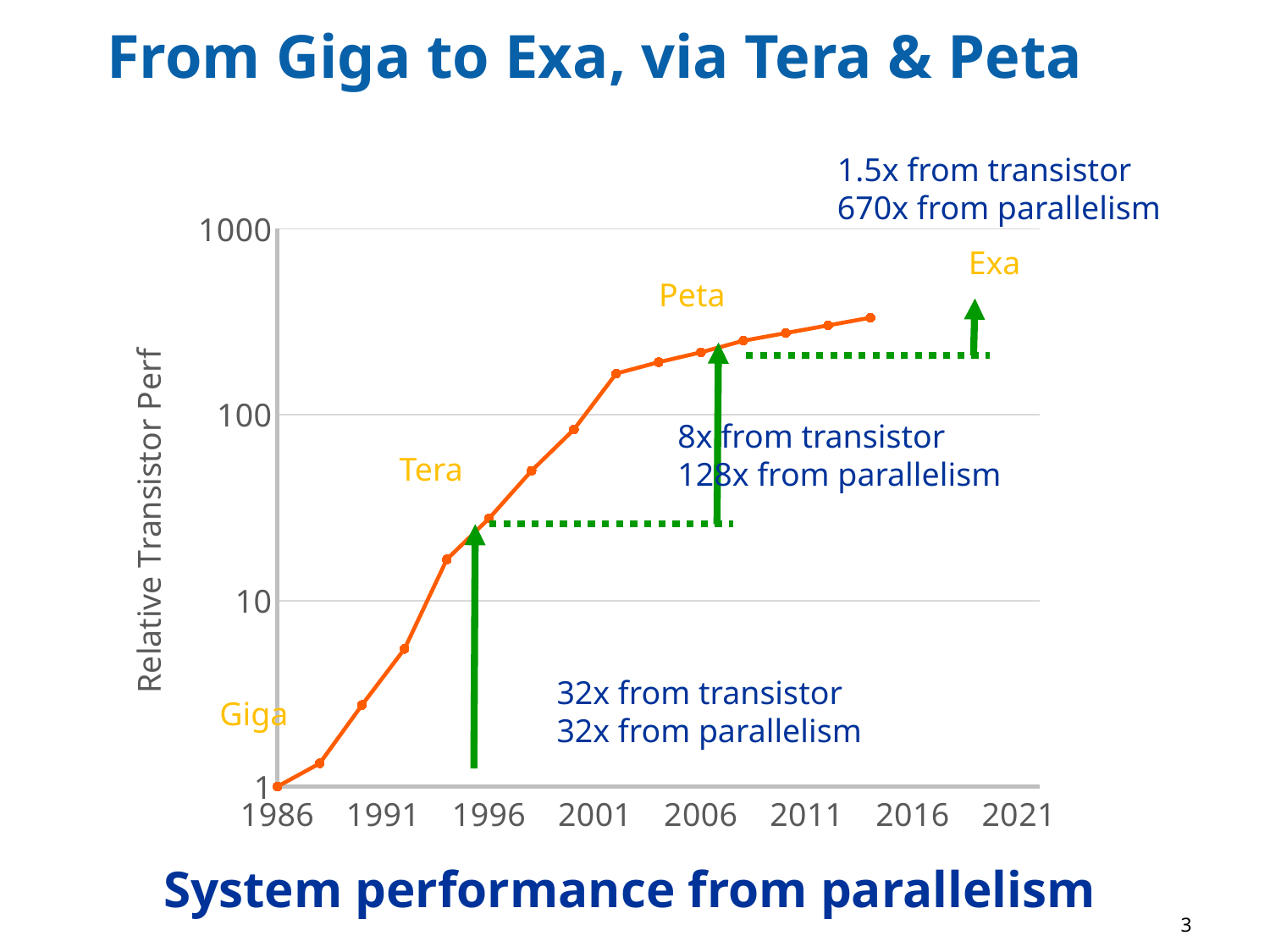
Is the value plotted for 1996 greater or less than 10? greater Which is larger, the value plotted for 2006 or the value plotted for 1998? 2006 What is the label of the y axis? Relative Transistor Perf What kind of chart is shown on the slide? line chart Do the plotted values rise or fall as the years increase along the x axis? rise Is the value plotted for 1996 greater or less than 100? less Which year has the lowest plotted value? 1986 Is the value plotted for 2014 greater or less than 1000? less What is the relative transistor performance value plotted for 1986? 1